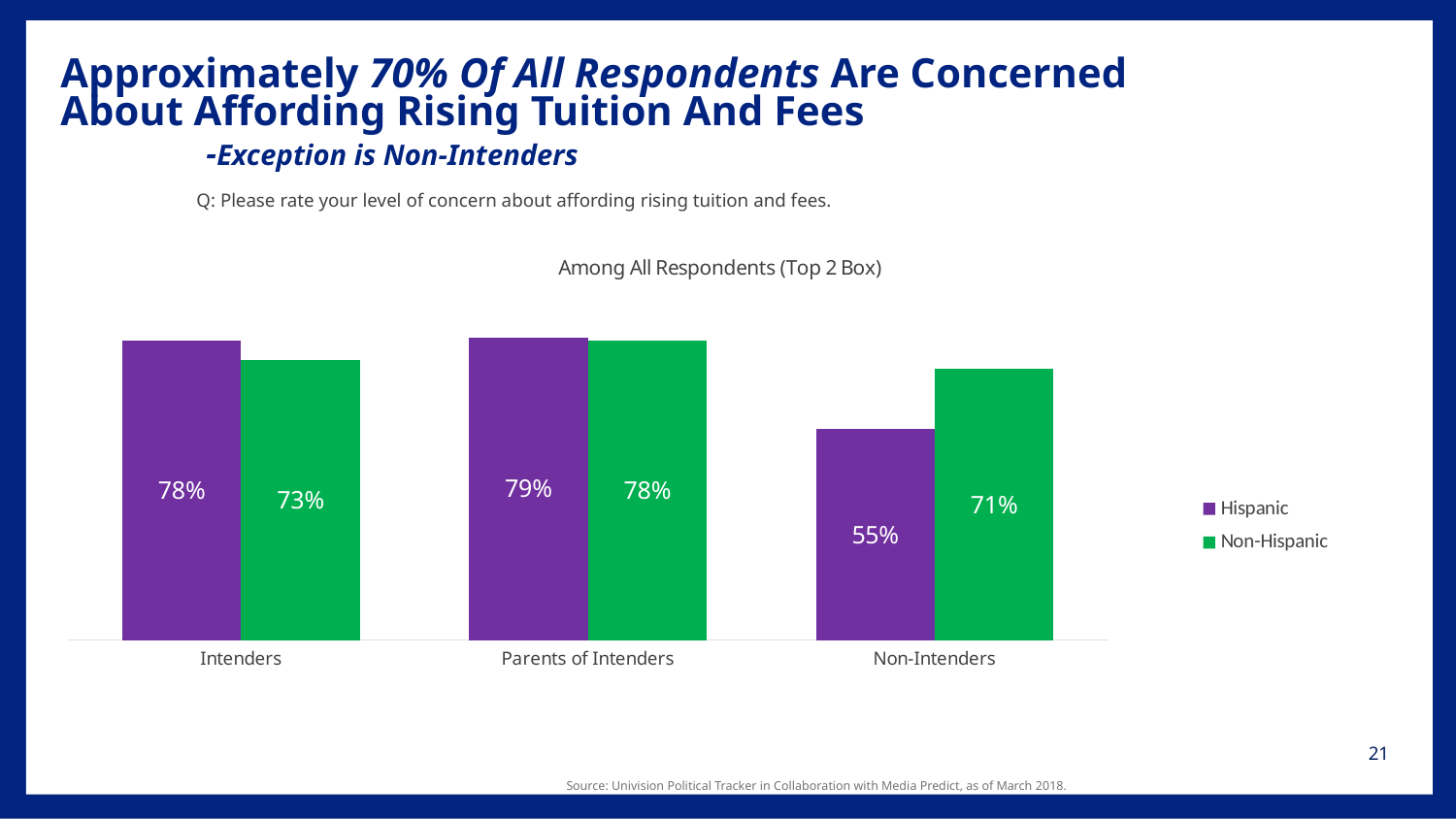
How many series does the legend list? 2 What is the difference between the Non-Hispanic and Hispanic values among Non-Intenders? 16% What is the difference between the Hispanic and Non-Hispanic values among Intenders? 5% What is the value for Non-Hispanic respondents among Non-Intenders? 71% What is the value for Hispanic respondents among Intenders? 78% Which category has the highest value for the Hispanic series? Parents of Intenders How many categories are shown on the x axis? 3 Among Non-Intenders, which is larger: the Hispanic value or the Non-Hispanic value? Non-Hispanic What is the value for Non-Hispanic respondents among Parents of Intenders? 78% What kind of chart is shown on the slide? Bar chart What is the value for Hispanic respondents among Non-Intenders? 55% Which category has the lowest value for the Hispanic series? Non-Intenders